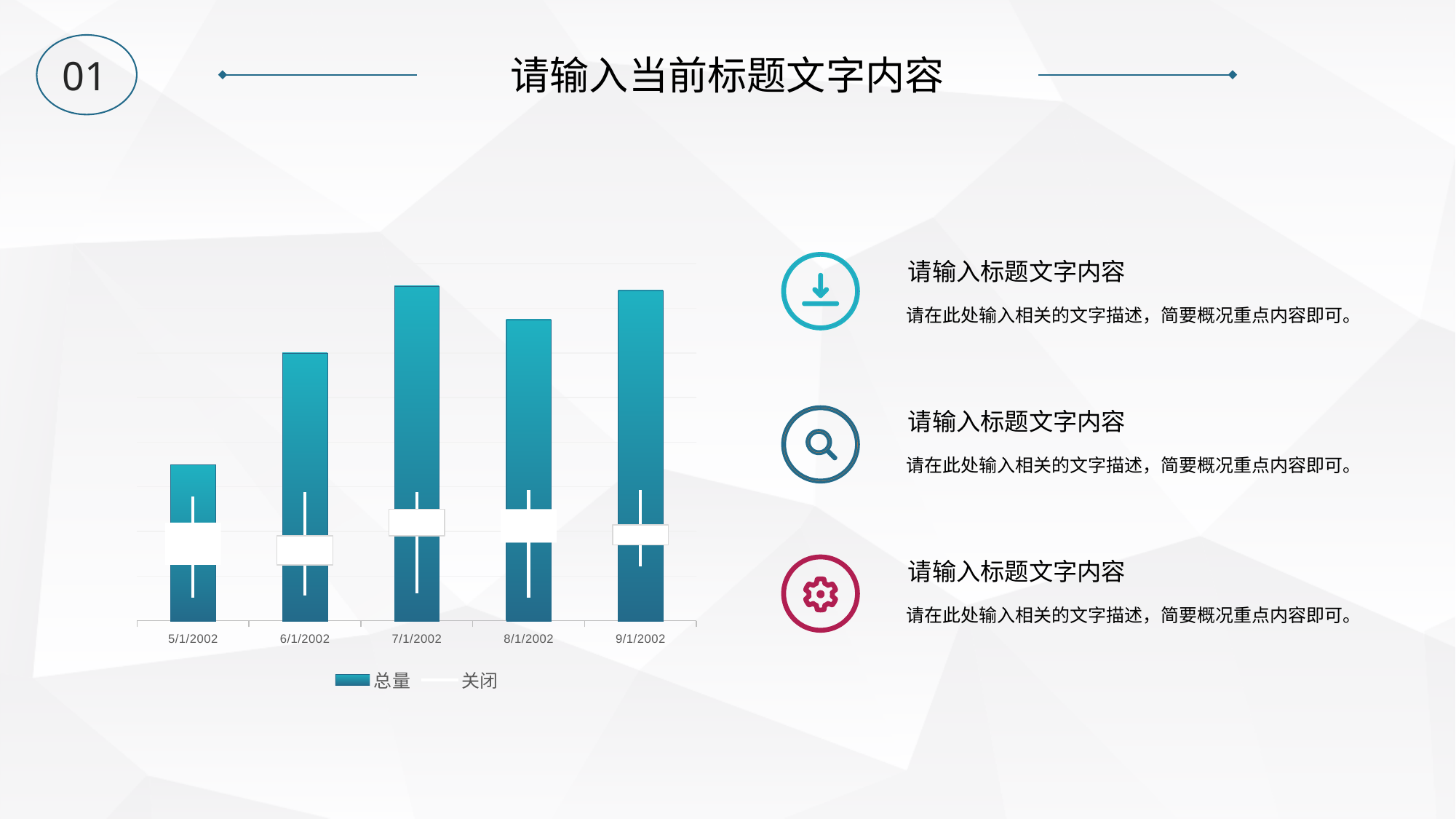
Is the 总量 bar for 6/1/2002 taller or shorter than the bar for 5/1/2002? taller What are the two series names listed in the chart legend? 总量 and 关闭 Is the 总量 bar for 8/1/2002 taller or shorter than the bar for 6/1/2002? taller How many series does the chart legend list? 2 Is the 总量 bar for 7/1/2002 taller or shorter than the bar for 8/1/2002? taller What kind of chart is shown on the slide? bar chart What is the first category label on the x axis? 5/1/2002 Which category has the lowest 总量 bar? 5/1/2002 How many categories are shown on the x axis of the chart? 5